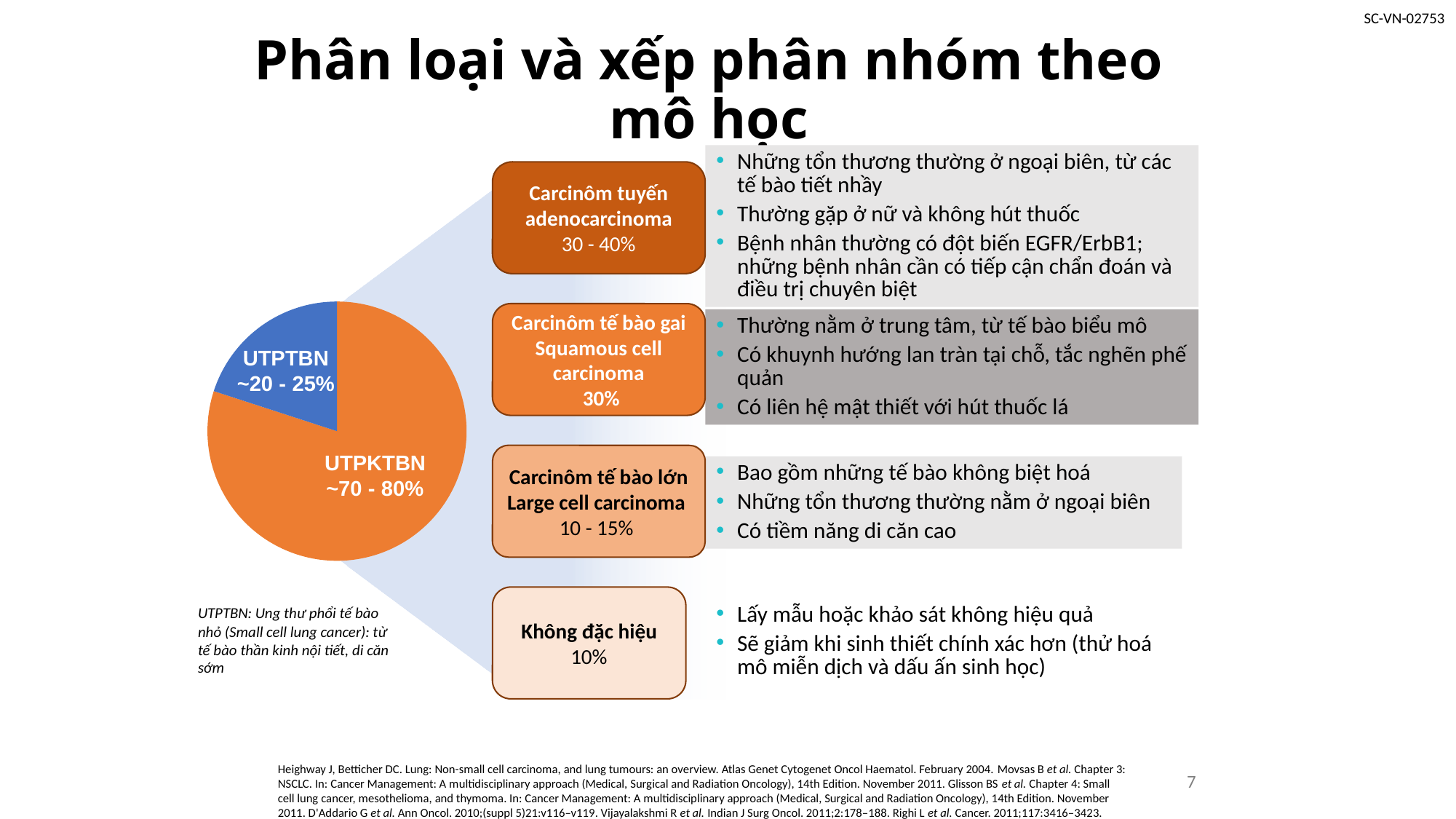
What value is printed on the UTPTBN slice of the pie chart? ~20 - 25% What kind of chart is shown on the left of the slide? pie chart Which slice of the pie chart is the smallest? UTPTBN What colour is the UTPTBN slice of the pie chart? blue Does the UTPKTBN slice take up more or less than half of the pie chart? more What value is printed on the UTPKTBN slice of the pie chart? ~70 - 80% What colour is the UTPKTBN slice of the pie chart? orange In the pie chart, which is larger: UTPTBN or UTPKTBN? UTPKTBN Which slice of the pie chart is the largest? UTPKTBN How many slices does the pie chart have? 2